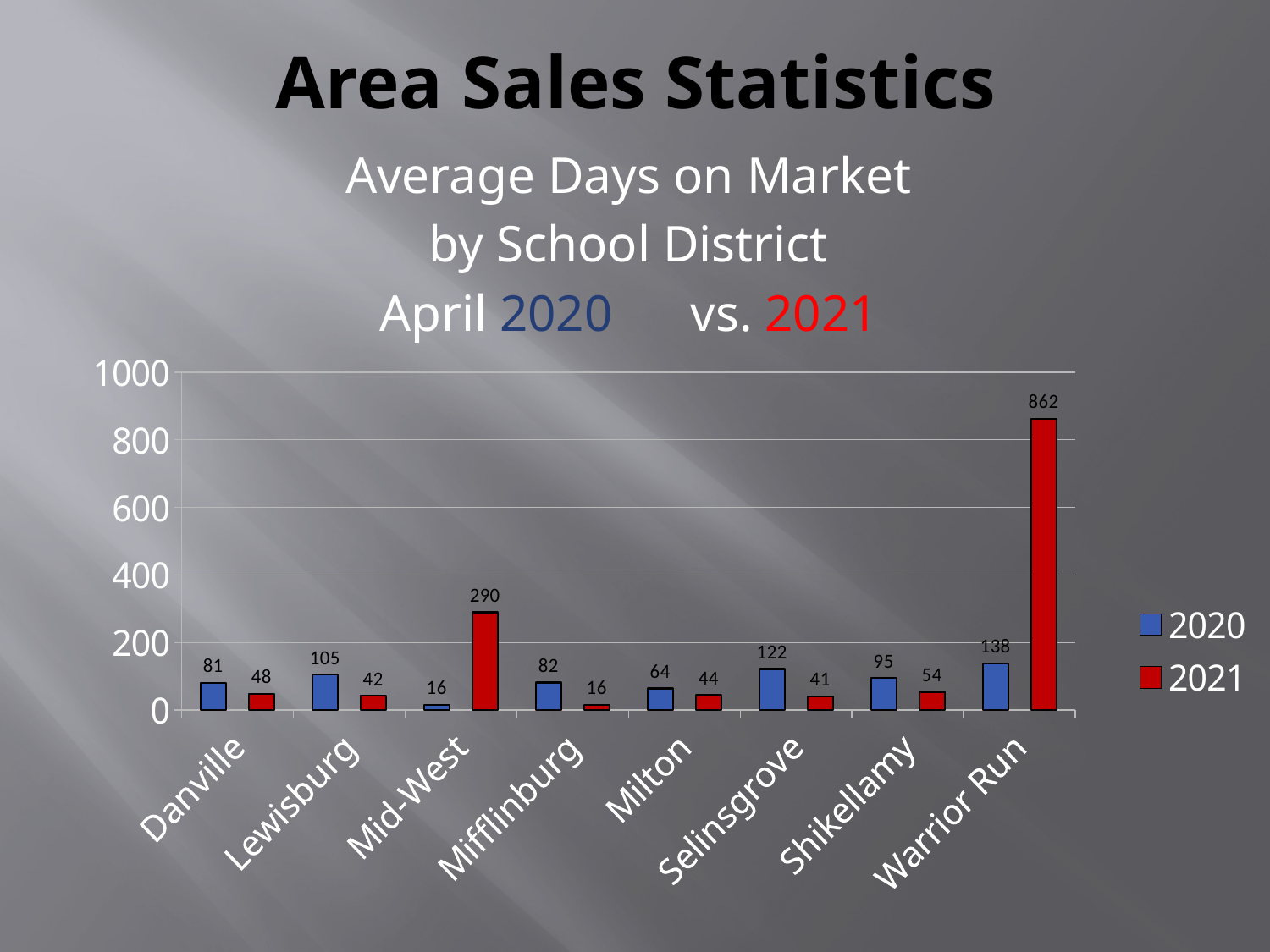
How many school districts are shown on the x axis? 8 Which is larger for Mifflinburg, the 2020 value or the 2021 value? 2020 Is the 2021 value for Warrior Run greater or less than 800? greater What kind of chart is shown on the slide? bar chart What is the 2021 average days on market for Warrior Run? 862 Which colour represents the 2021 series in the chart? red What is the 2021 value for Mid-West? 290 What is the 2020 average days on market for Lewisburg? 105 Which school district has the highest 2021 value? Warrior Run What is the difference between the 2020 and 2021 values for Danville? 33 How many series does the legend list? 2 Which school district has the lowest 2020 value? Mid-West